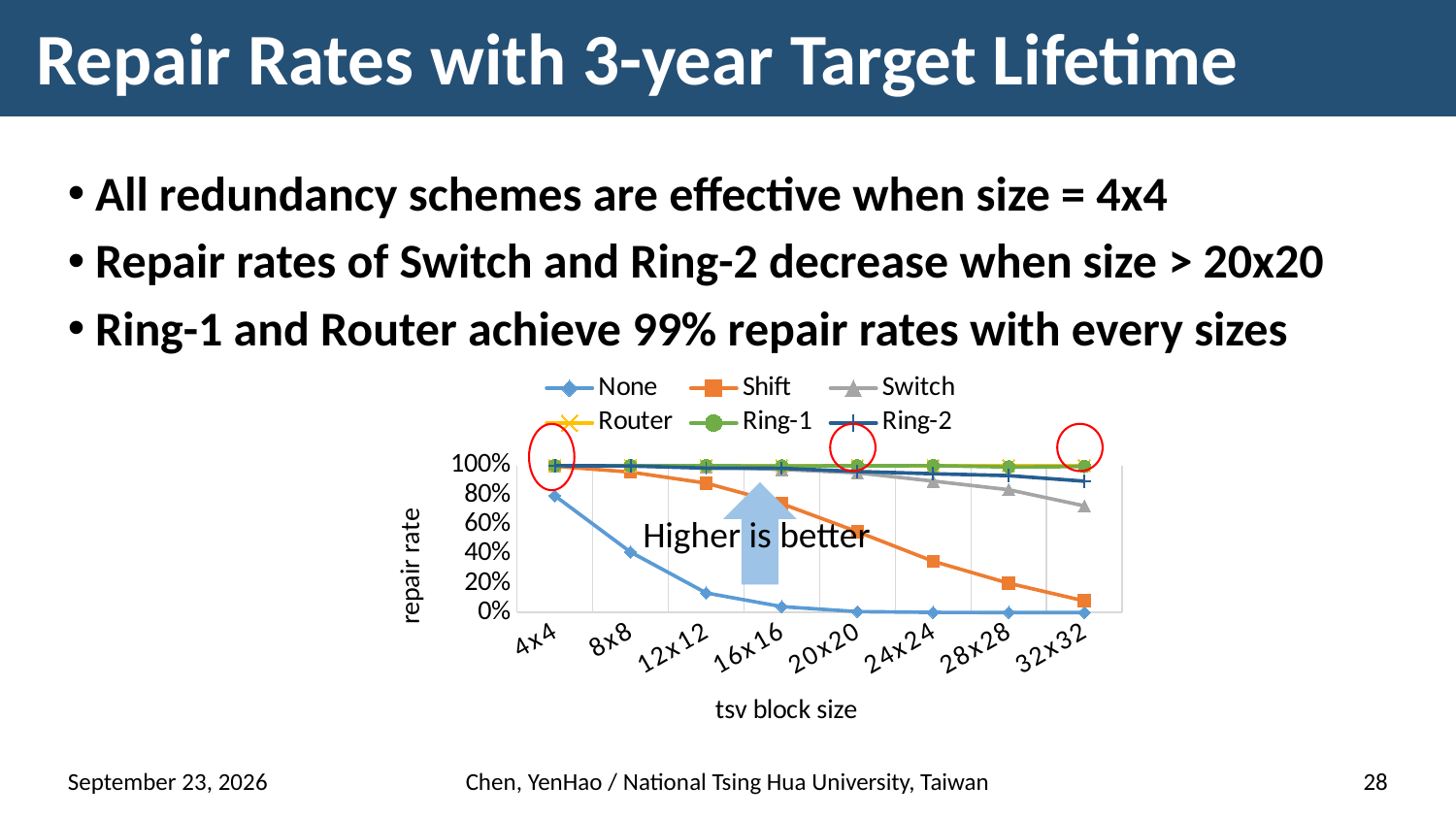
Is the repair rate for Switch at 32x32 greater or less than 60%? greater How many tsv block sizes are plotted along the x axis? 8 Is the repair rate for None at 4x4 greater or less than 60%? greater Does the repair rate for None rise or fall as the tsv block size increases? fall Is the repair rate for Shift at 24x24 greater or less than 60%? less At 16x16, which has the higher repair rate, None or Shift? Shift What is the title of the chart's x axis? tsv block size What kind of chart is shown on the slide? line chart Which series has the lowest repair rate at 32x32? None At 32x32, which has the higher repair rate, Shift or Switch? Switch How many series does the chart's legend list? 6